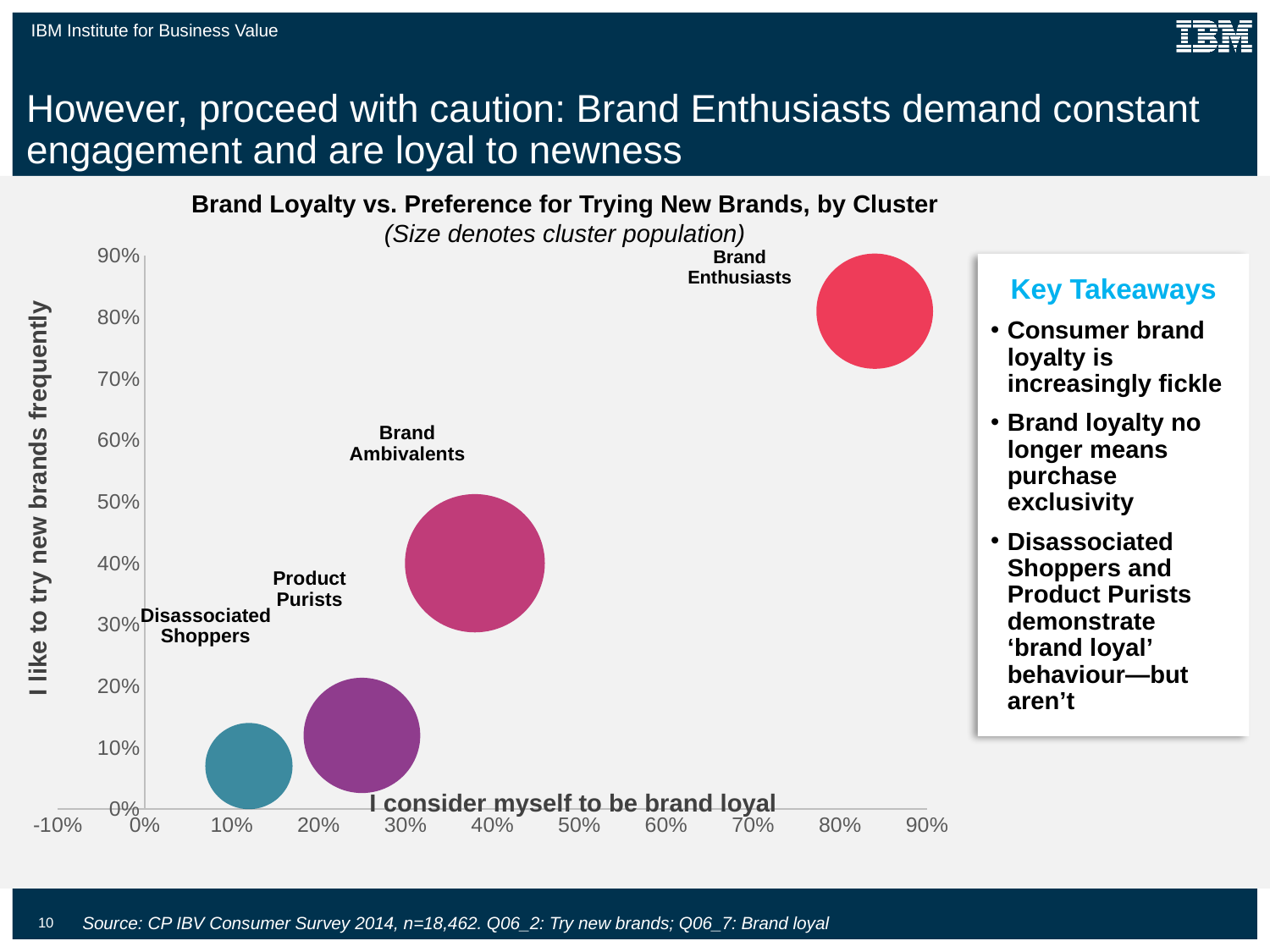
Which cluster has a higher 'I consider myself to be brand loyal' value, Product Purists or Disassociated Shoppers? Product Purists Which cluster has a higher 'I like to try new brands frequently' value, Brand Ambivalents or Product Purists? Brand Ambivalents Is the 'I like to try new brands frequently' value for Disassociated Shoppers greater or less than 20%? less Is the 'I consider myself to be brand loyal' value for Product Purists greater or less than 40%? less What kind of chart is shown on the slide? Bubble chart According to the chart subtitle, what does the size of each bubble denote? Cluster population Which cluster has the lowest value on the 'I consider myself to be brand loyal' axis? Disassociated Shoppers Which cluster has the highest value on the 'I like to try new brands frequently' axis? Brand Enthusiasts Is the 'I like to try new brands frequently' value for Brand Ambivalents greater or less than 30%? greater What is the title of the chart? Brand Loyalty vs. Preference for Trying New Brands, by Cluster How many clusters are plotted on the chart? 4